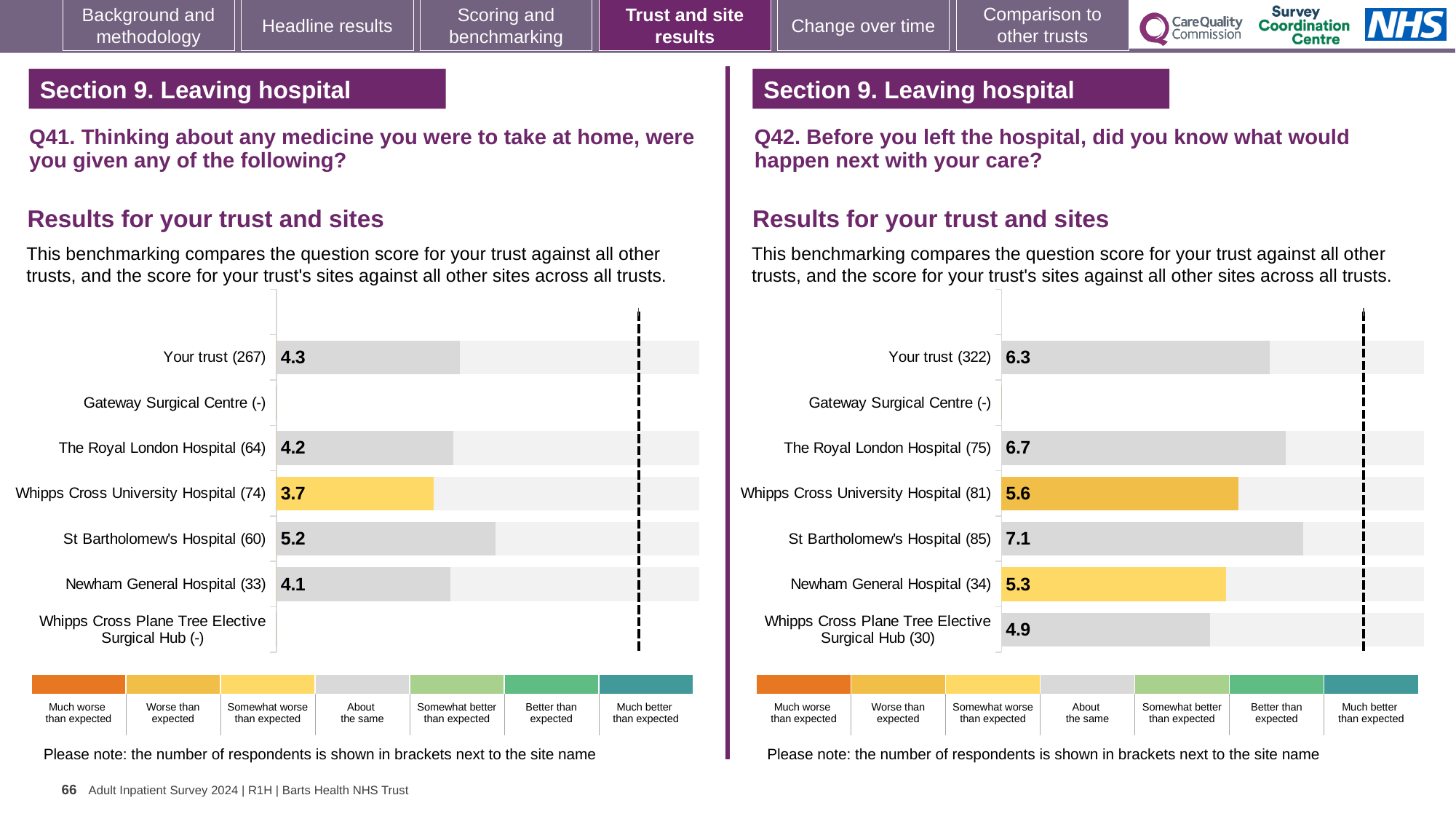
What type of chart is used on this slide? Bar chart In the Q42 chart on the right, what is the score for Whipps Cross Plane Tree Elective Surgical Hub? 4.9 In the Q42 chart on the right, what is the difference between the scores for St Bartholomew's Hospital and Newham General Hospital? 1.8 In the Q42 chart on the right, which is higher: the score for The Royal London Hospital or Newham General Hospital? The Royal London Hospital In the Q41 chart on the left, how many respondents are shown for Your trust? 267 In the Q41 chart on the left, what is the difference between the scores for St Bartholomew's Hospital and Whipps Cross University Hospital? 1.5 In the Q42 chart on the right, which colour category does the Whipps Cross University Hospital bar fall into according to the legend? Worse than expected In the Q42 chart on the right, which site has the lowest score? Whipps Cross Plane Tree Elective Surgical Hub In the Q41 chart on the left, what is the score for Whipps Cross University Hospital? 3.7 In the Q42 chart on the right, what is the score for Your trust? 6.3 In the Q41 chart on the left, which site has the highest score? St Bartholomew's Hospital In the Q41 chart on the left, what is the score for St Bartholomew's Hospital? 5.2